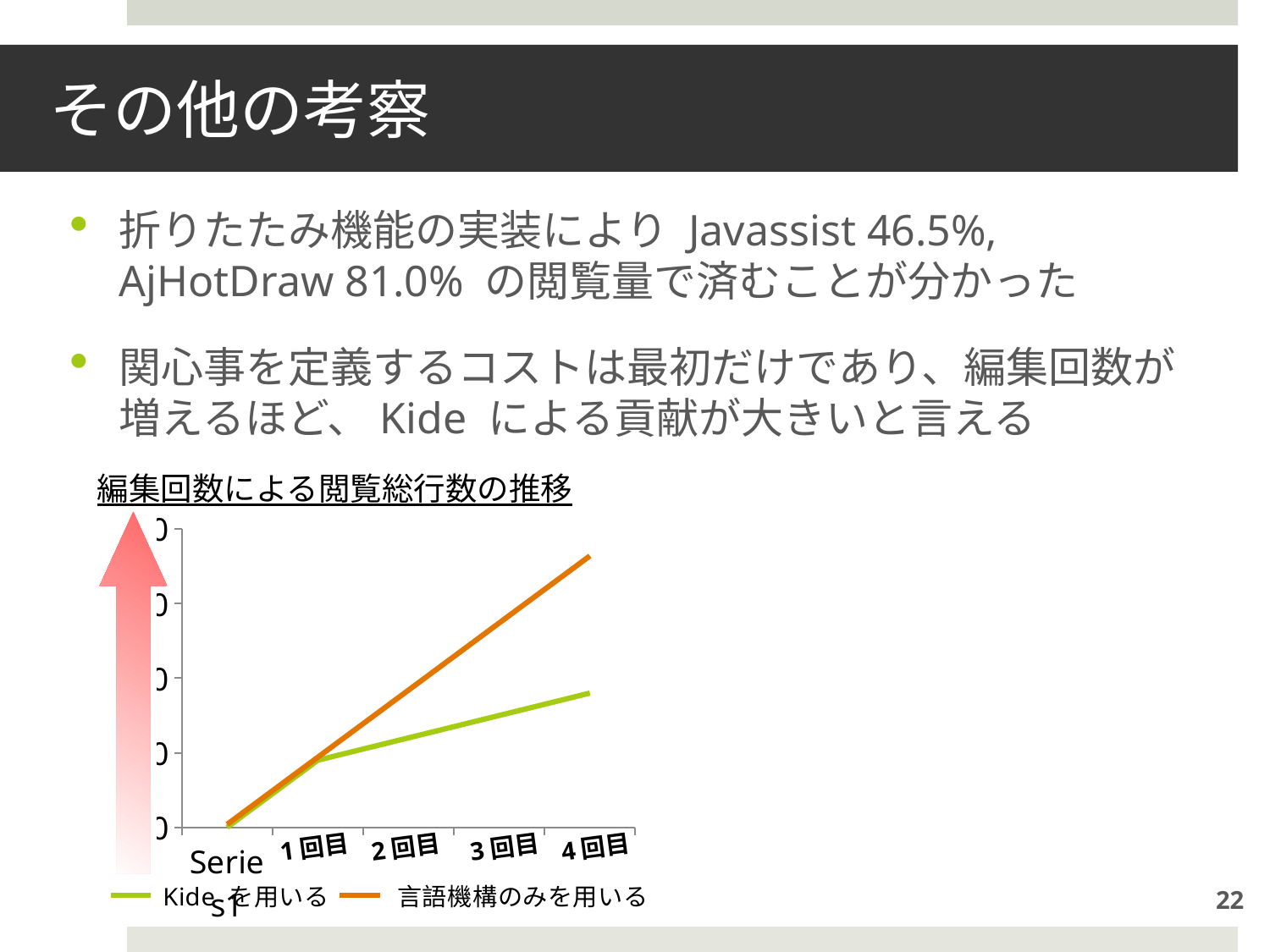
Does the 言語機構のみを用いる line rise or fall from 1回目 to 4回目? rise At 4回目, which series has the higher value, Kideを用いる or 言語機構のみを用いる? 言語機構のみを用いる Which series reaches the highest value on the chart? 言語機構のみを用いる What is the title written above the chart? 編集回数による閲覧総行数の推移 Does the Kideを用いる line rise or fall from 1回目 to 4回目? rise What kind of chart is shown on the slide? line chart Which series is drawn with the orange line? 言語機構のみを用いる How many series does the chart legend list? 2 At 3回目, which series has the higher value, Kideを用いる or 言語機構のみを用いる? 言語機構のみを用いる How many 回目 categories are labelled on the x axis? 4 At which x-axis category does the Kideを用いる line reach its highest value? 4回目